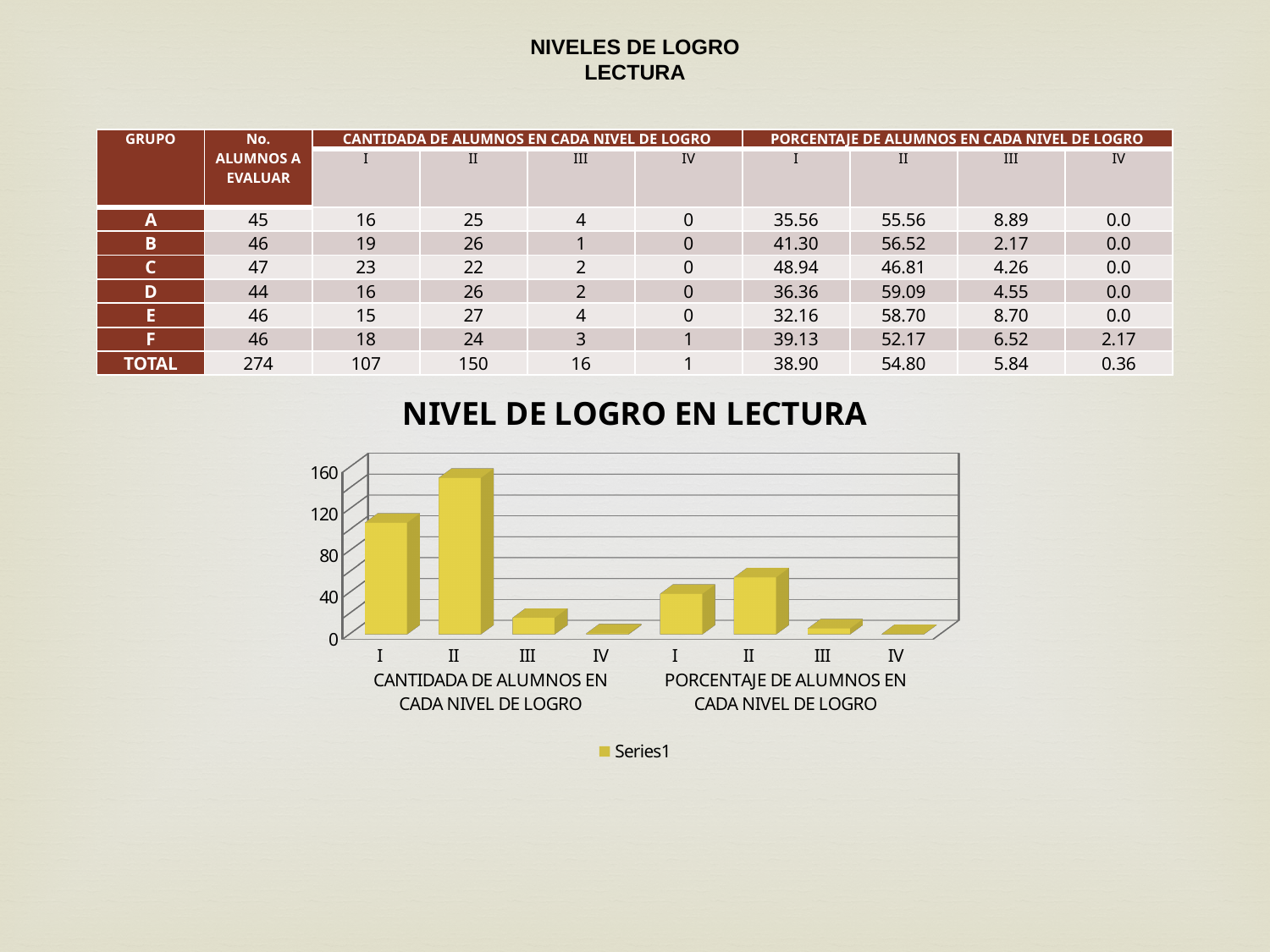
How many series does the chart legend list? 1 Is the value for level II under CANTIDADA DE ALUMNOS EN CADA NIVEL DE LOGRO greater or less than 120? greater Which is larger: the bar for level III under CANTIDADA DE ALUMNOS EN CADA NIVEL DE LOGRO or the bar for level II under PORCENTAJE DE ALUMNOS EN CADA NIVEL DE LOGRO? II under PORCENTAJE DE ALUMNOS EN CADA NIVEL DE LOGRO Which bar is the highest in the chart? II under CANTIDADA DE ALUMNOS EN CADA NIVEL DE LOGRO How many bars are plotted in the chart? 8 Which is larger: the bar for level I or the bar for level II under CANTIDADA DE ALUMNOS EN CADA NIVEL DE LOGRO? II What type of chart is shown under the title 'NIVEL DE LOGRO EN LECTURA'? bar chart Is the value for level III under CANTIDADA DE ALUMNOS EN CADA NIVEL DE LOGRO greater or less than 40? less What series name does the chart legend list? Series1 Is the value for level II under PORCENTAJE DE ALUMNOS EN CADA NIVEL DE LOGRO greater or less than 40? greater What is the title of the chart on the slide? NIVEL DE LOGRO EN LECTURA